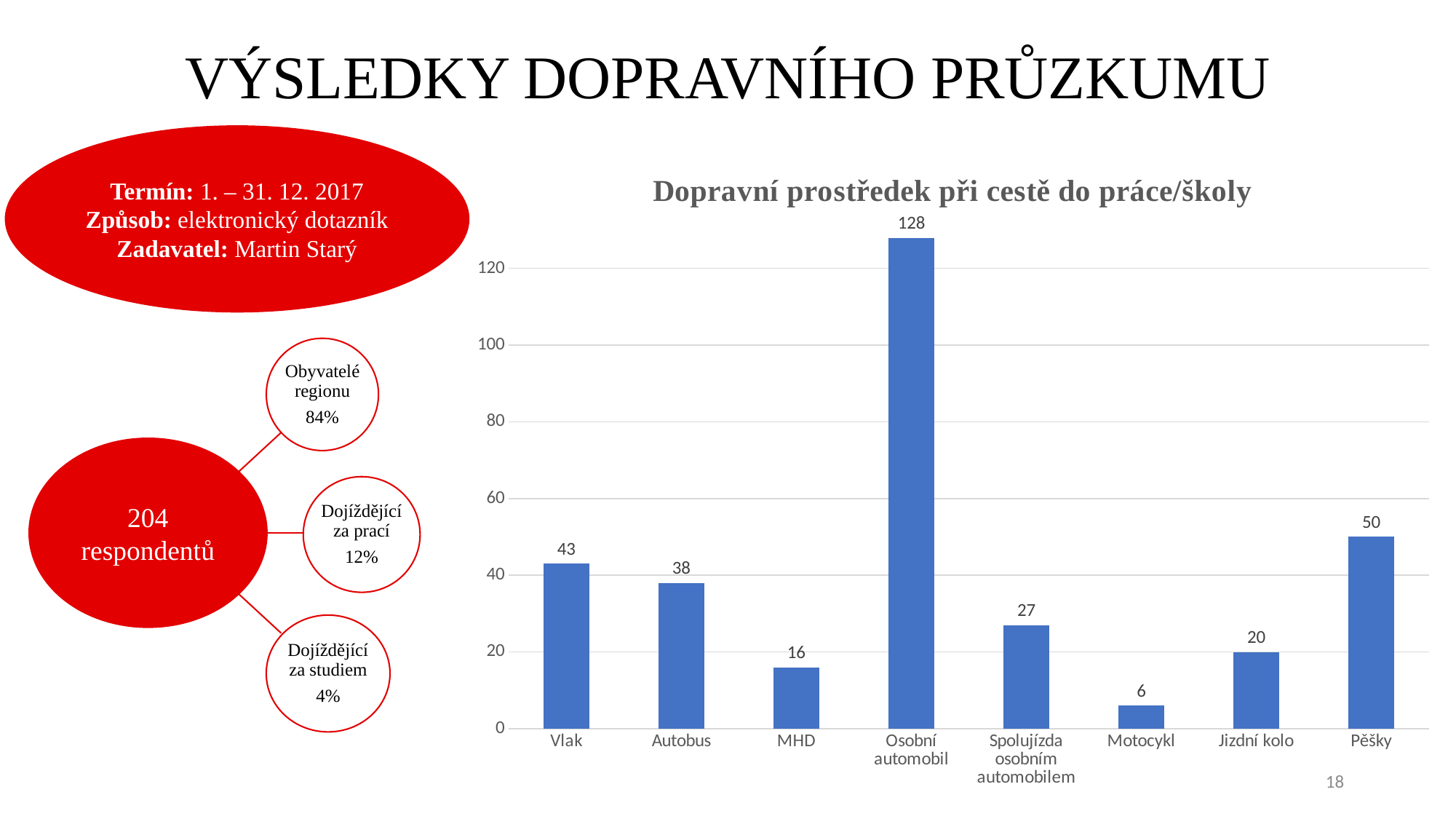
What kind of chart is shown on the slide? bar chart Which is larger, the value for Vlak or the value for Autobus? Vlak What is the value for Vlak? 43 What is the value for Pěšky? 50 What is the difference between the values for MHD and Motocykl? 10 Is the value for Jízdní kolo greater or less than 40? less Which category has the highest value? Osobní automobil What is the value for Spolujízda osobním automobilem? 27 What is the title of the chart? Dopravní prostředek při cestě do práce/školy How many categories are shown on the x axis? 8 Which category has the lowest value? Motocykl What is the difference between the values for Osobní automobil and Pěšky? 78